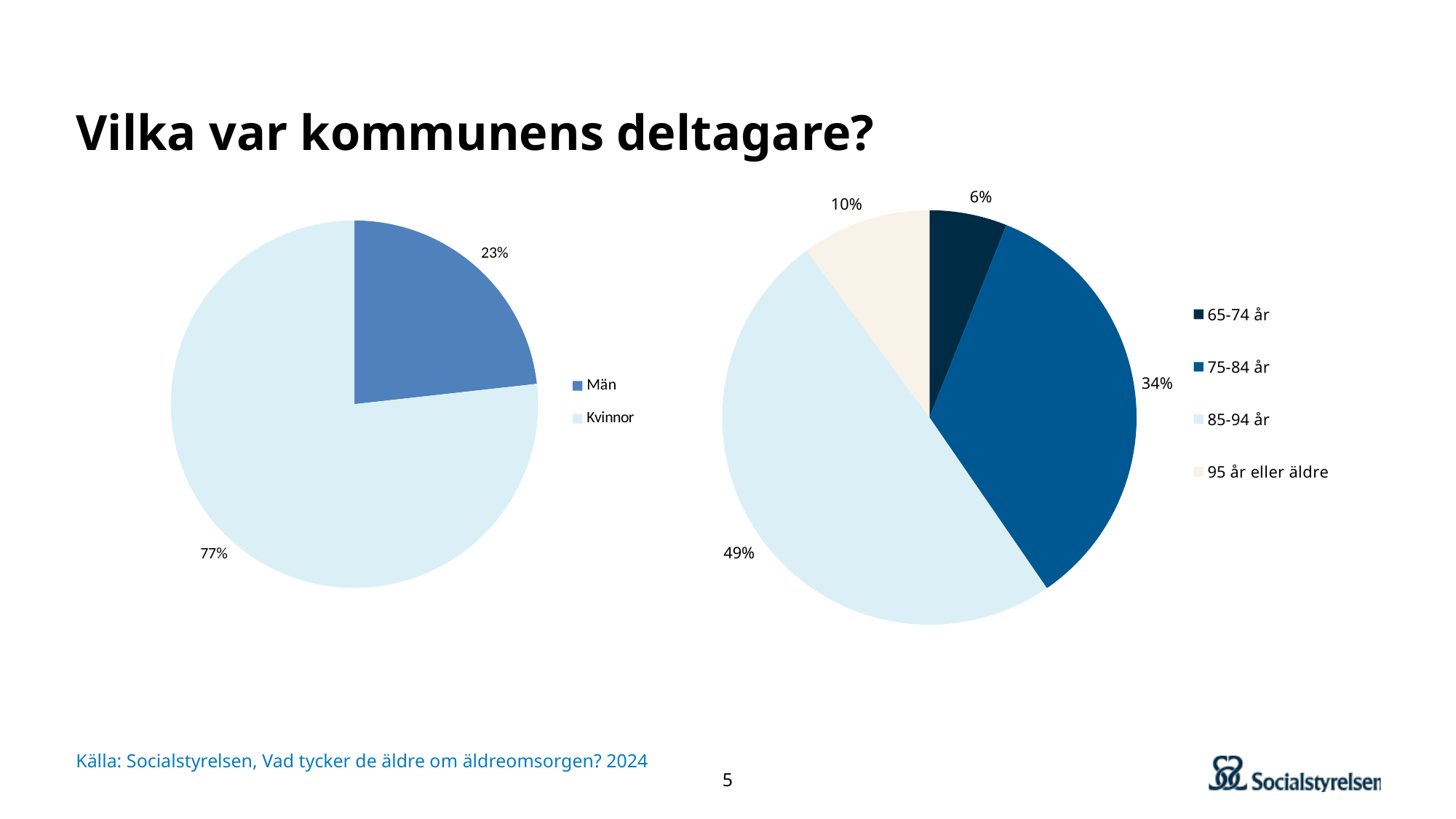
In the left pie chart, what is the difference in percentage points between Kvinnor and Män? 54 In the right pie chart, what share of participants are 95 år eller äldre? 10% What kind of chart is the right chart on the slide? Pie chart In the right pie chart, what is the difference in percentage points between 85-94 år and 75-84 år? 15 In the right pie chart, which age group has the smallest share? 65-74 år In the left pie chart, what share of participants are Män? 23% In the right pie chart, what share of participants are 65-74 år? 6% In the right pie chart, which age group has the largest share? 85-94 år How many series does the legend of the left pie chart list? 2 In the left pie chart, which category has the larger share, Män or Kvinnor? Kvinnor In the right pie chart, what share of participants are 85-94 år? 49% In the left pie chart, what share of participants are Kvinnor? 77%